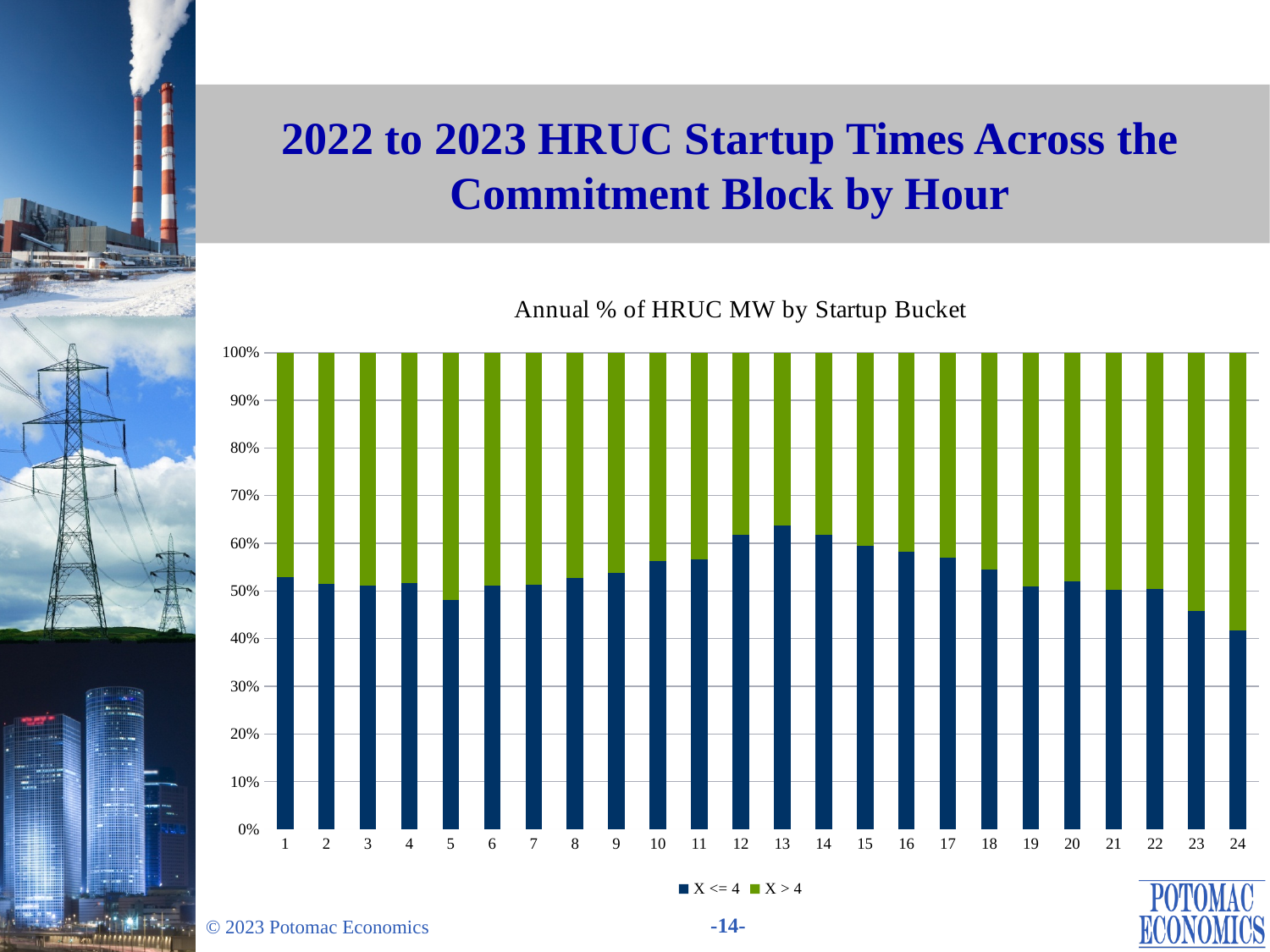
Which legend entry is shown in blue? X <= 4 What is the title of the chart? Annual % of HRUC MW by Startup Bucket Which hour has the larger X <= 4 share, hour 5 or hour 12? 12 Is the value for X <= 4 at hour 13 greater or less than 60%? greater How many series does the legend list? 2 What is the total height of the stacked bar for hour 13? 100% What kind of chart is shown on the slide? stacked bar chart Is the value for X <= 4 at hour 24 greater or less than 50%? less Is the value for X <= 4 at hour 5 greater or less than 50%? less How many hours (categories) are shown on the x axis? 24 Which hour has the highest share for X > 4? 24 Which hour has the lowest share for X <= 4? 24